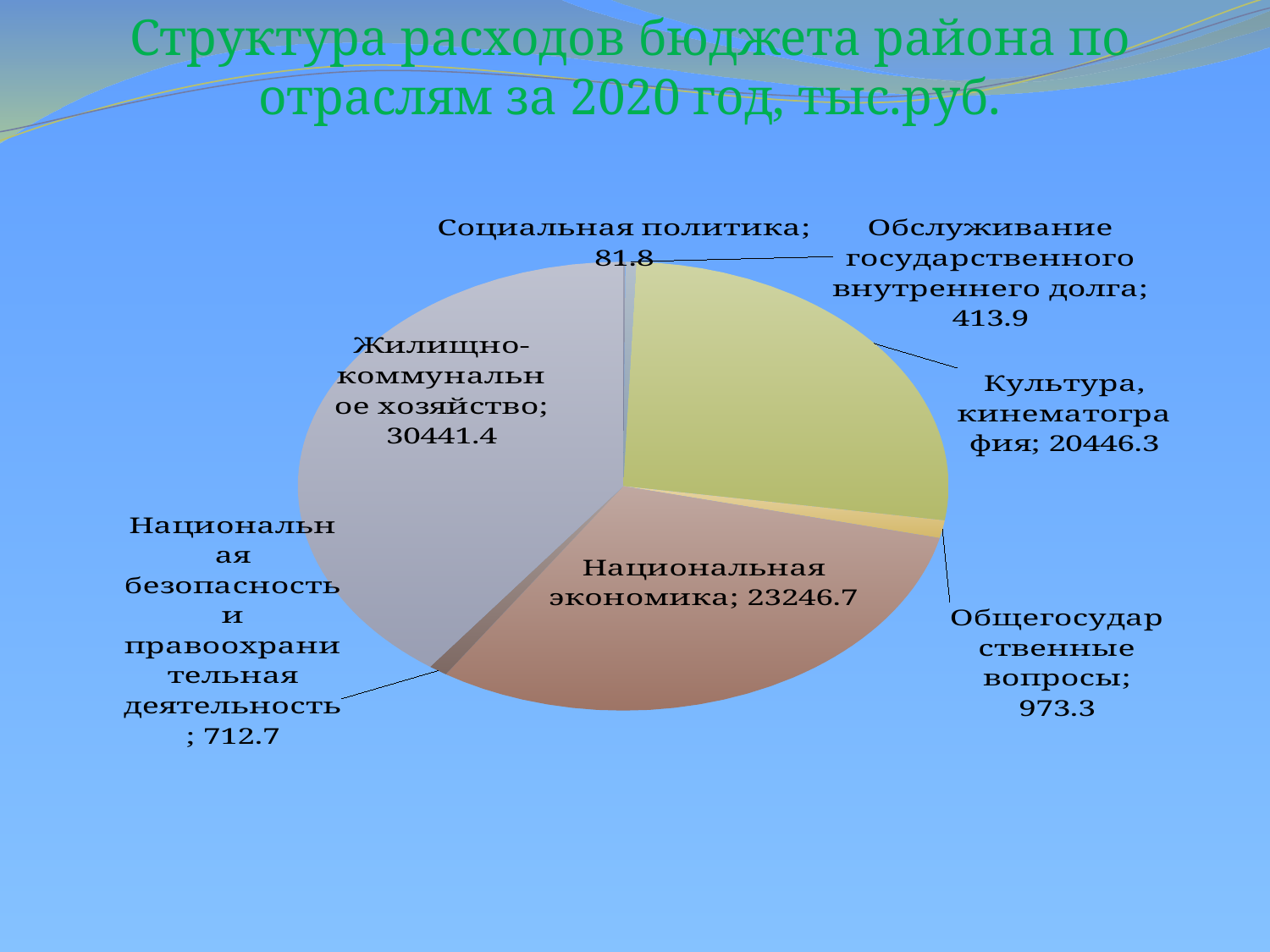
What is the difference between Жилищно-коммунальное хозяйство and Национальная экономика? 7194.7 Which category has the largest value? Жилищно-коммунальное хозяйство What kind of chart is shown on the slide? pie chart What is the value for Общегосударственные вопросы? 973.3 Which category has the smallest value? Социальная политика How many categories does the pie chart show? 7 What is the value for Социальная политика? 81.8 What is the value for Культура, кинематография? 20446.3 What is the value for Национальная экономика? 23246.7 What is the title of the chart? Структура расходов бюджета района по отраслям за 2020 год, тыс.руб. Which is larger: Общегосударственные вопросы or Национальная безопасность и правоохранительная деятельность? Общегосударственные вопросы What is the value for Жилищно-коммунальное хозяйство? 30441.4